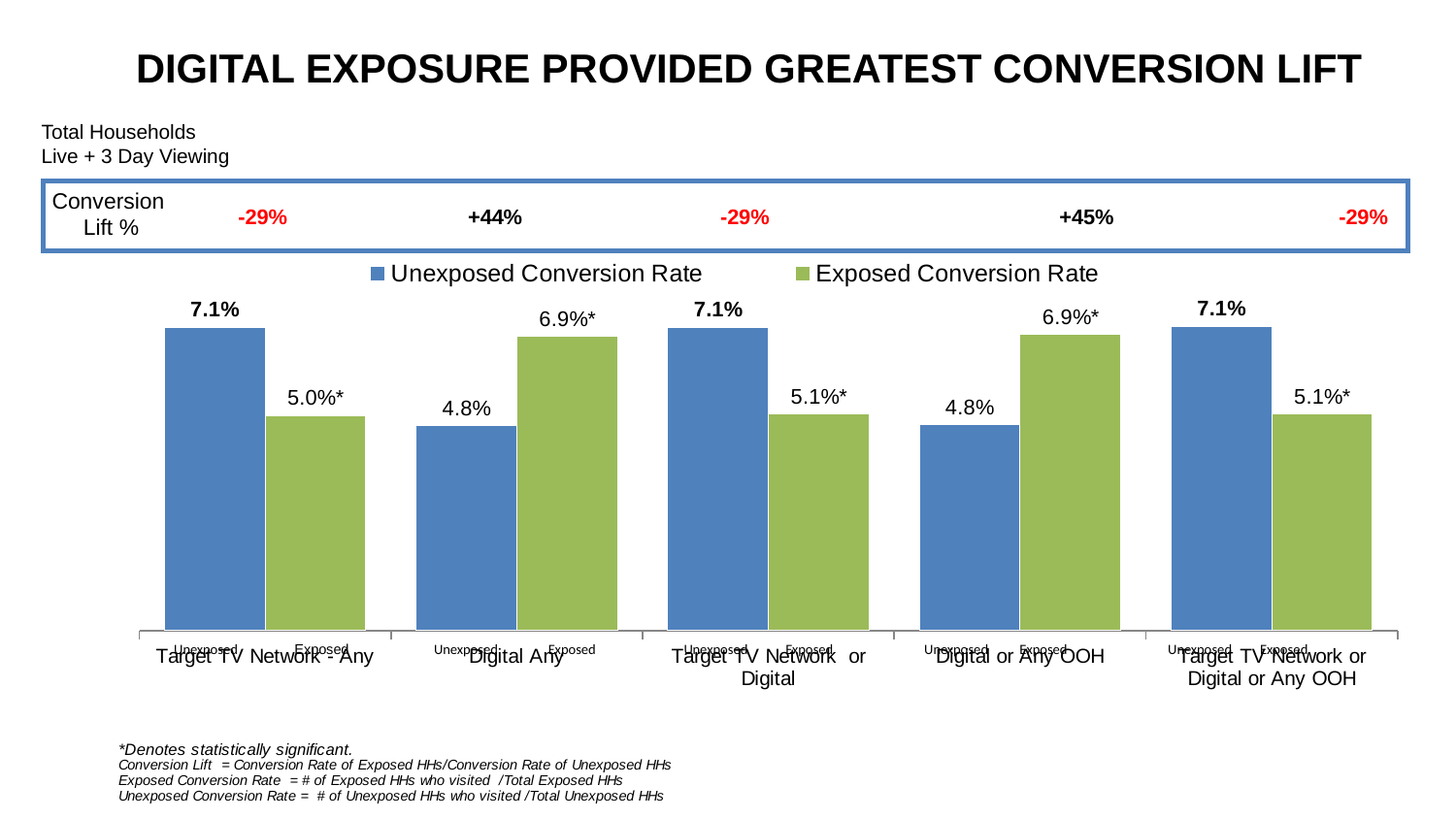
What colour are the Exposed Conversion Rate bars? green What kind of chart is shown on the slide? bar chart What is the Unexposed Conversion Rate for Target TV Network - Any? 7.1% How many category groups are shown on the x axis of the chart? 5 Which category has the lowest Unexposed Conversion Rate? Digital Any and Digital or Any OOH (4.8%) What Conversion Lift % is shown above the Digital or Any OOH group? +45% How many series does the legend list? 2 What is the difference between the Unexposed and Exposed Conversion Rates for Target TV Network - Any? 2.1% What is the Exposed Conversion Rate for Digital Any? 6.9%* What is the Exposed Conversion Rate for Target TV Network or Digital or Any OOH? 5.1%* What is the Unexposed Conversion Rate for Digital or Any OOH? 4.8% Which is larger for Digital Any: the Unexposed Conversion Rate or the Exposed Conversion Rate? Exposed Conversion Rate